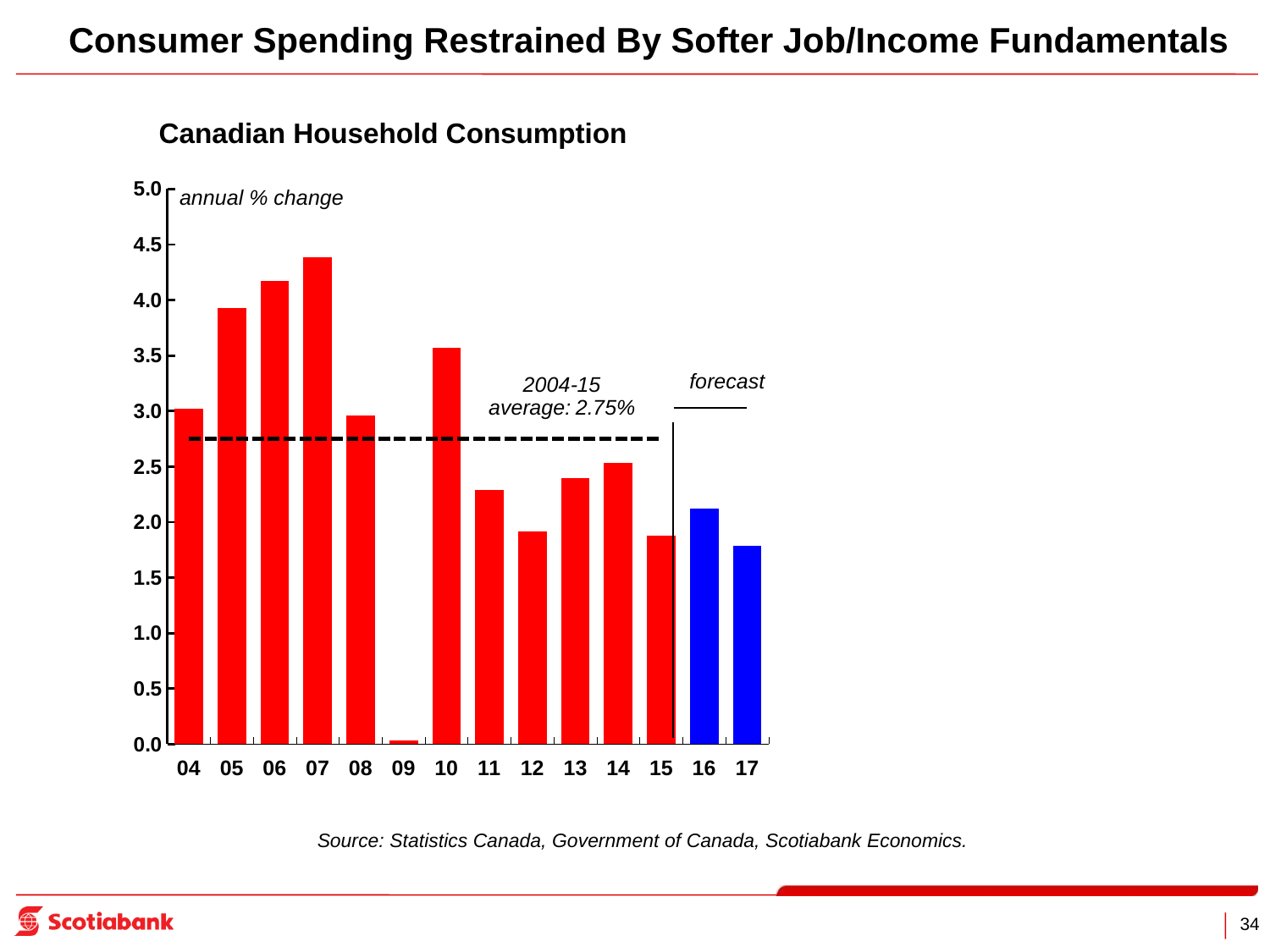
Is the value for 05 greater or less than 3.5? greater How many years (bars) are plotted on the chart? 14 Is the value for 17 greater or less than 2.0? less Do the values rise or fall from 04 to 07? rise Which year has the lowest annual % change in household consumption? 09 Is the value for 10 greater or less than 3.0? greater What 2004-15 average is marked by the dashed line on the chart? 2.75% What is the title of the chart? Canadian Household Consumption Which year has the larger value, 06 or 14? 06 What kind of chart is shown on the slide? bar chart Which year has the highest annual % change in household consumption? 07